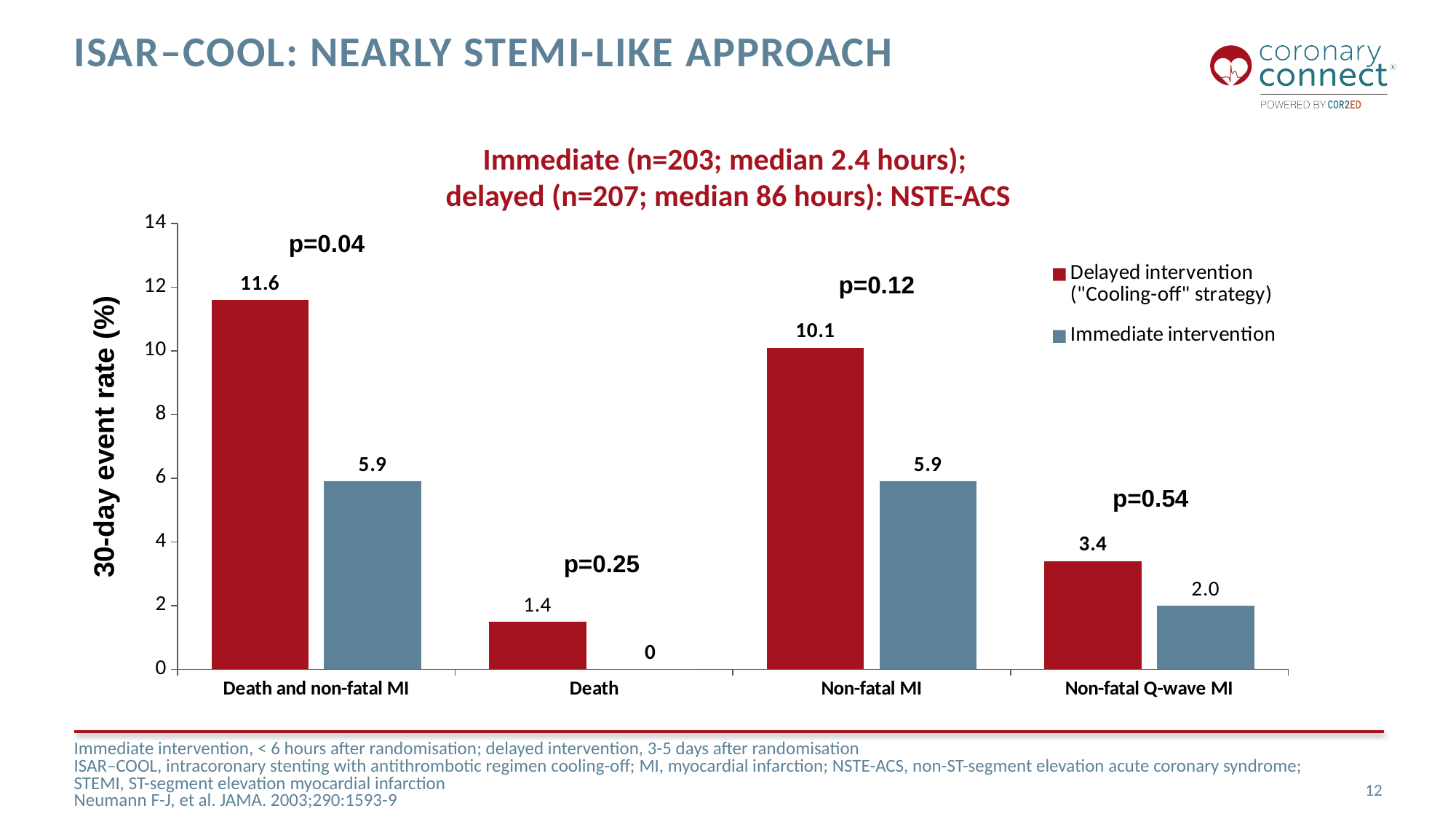
Which category has the lowest value for Delayed intervention? Death How many series does the legend list? 2 What is the difference between Delayed intervention and Immediate intervention in the Non-fatal MI category? 4.2 What is the label of the y axis? 30-day event rate (%) What is the 30-day event rate for Immediate intervention in the Non-fatal Q-wave MI category? 2.0 What kind of chart is shown on the slide? Bar chart Which category has the highest value for Delayed intervention? Death and non-fatal MI What is the p-value shown above the Death and non-fatal MI category? p=0.04 How many categories are shown on the x axis? 4 Which is larger in the Non-fatal Q-wave MI category: Delayed intervention or Immediate intervention? Delayed intervention What is the value for Immediate intervention in the Death category? 0 What is the 30-day event rate for Delayed intervention in the Death and non-fatal MI category? 11.6